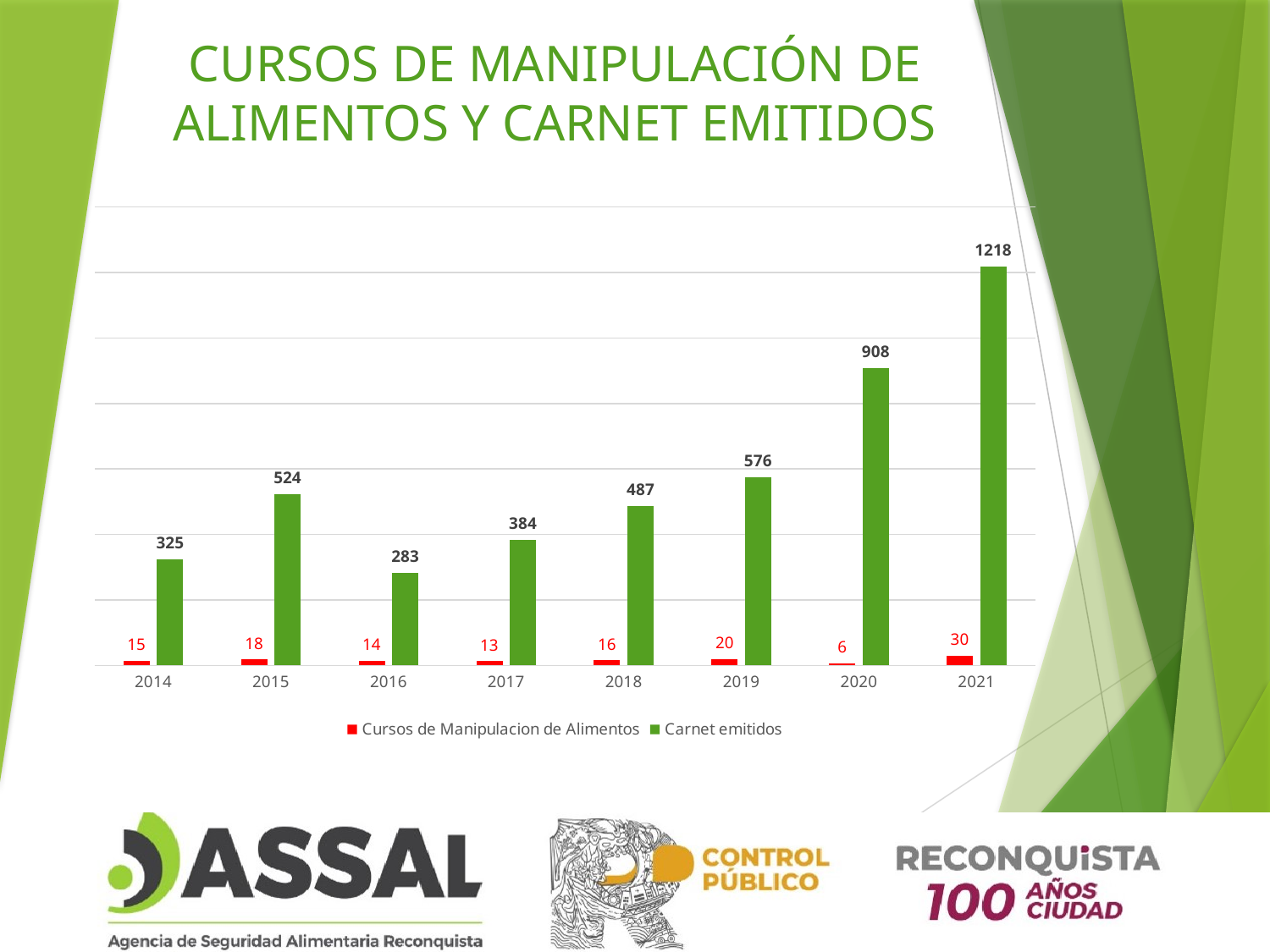
How many years are shown on the x axis? 8 Which is larger, Carnet emitidos in 2015 or in 2017? 2015 What is the value of Carnet emitidos for 2016? 283 What is the value of Cursos de Manipulacion de Alimentos for 2020? 6 What colour are the bars for Cursos de Manipulacion de Alimentos? Red Do the values for Carnet emitidos rise or fall from 2018 to 2021? Rise Which year has the highest value for Carnet emitidos? 2021 Which year has the lowest value for Cursos de Manipulacion de Alimentos? 2020 What is the difference between Carnet emitidos in 2021 and 2020? 310 How many series does the legend list? 2 What kind of chart is shown on the slide? Bar chart What is the value of Carnet emitidos for 2021? 1218